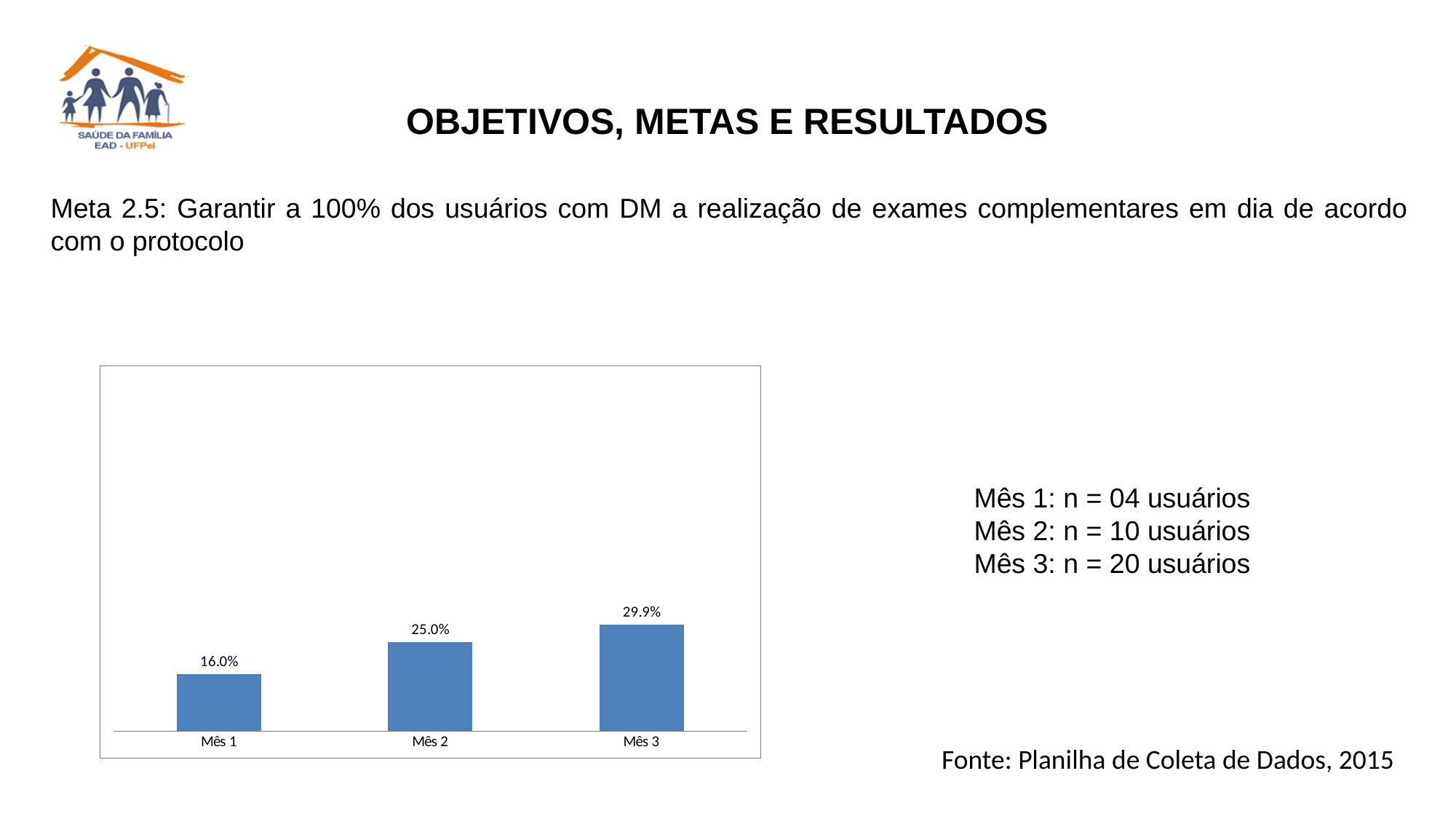
Do the values rise or fall from Mês 1 to Mês 3? Rise What is the value for Mês 3? 29.9% Which month has the lowest value? Mês 1 How many categories are shown on the x axis of the chart? 3 What is the value for Mês 1? 16.0% What is the value for Mês 2? 25.0% What colour are the bars in the chart? Blue What kind of chart is shown on the slide? Bar chart What is the difference between the values for Mês 3 and Mês 1? 13.9% What is the difference between the values for Mês 2 and Mês 1? 9.0% Which is larger, the value for Mês 2 or the value for Mês 3? Mês 3 Which month has the highest value? Mês 3